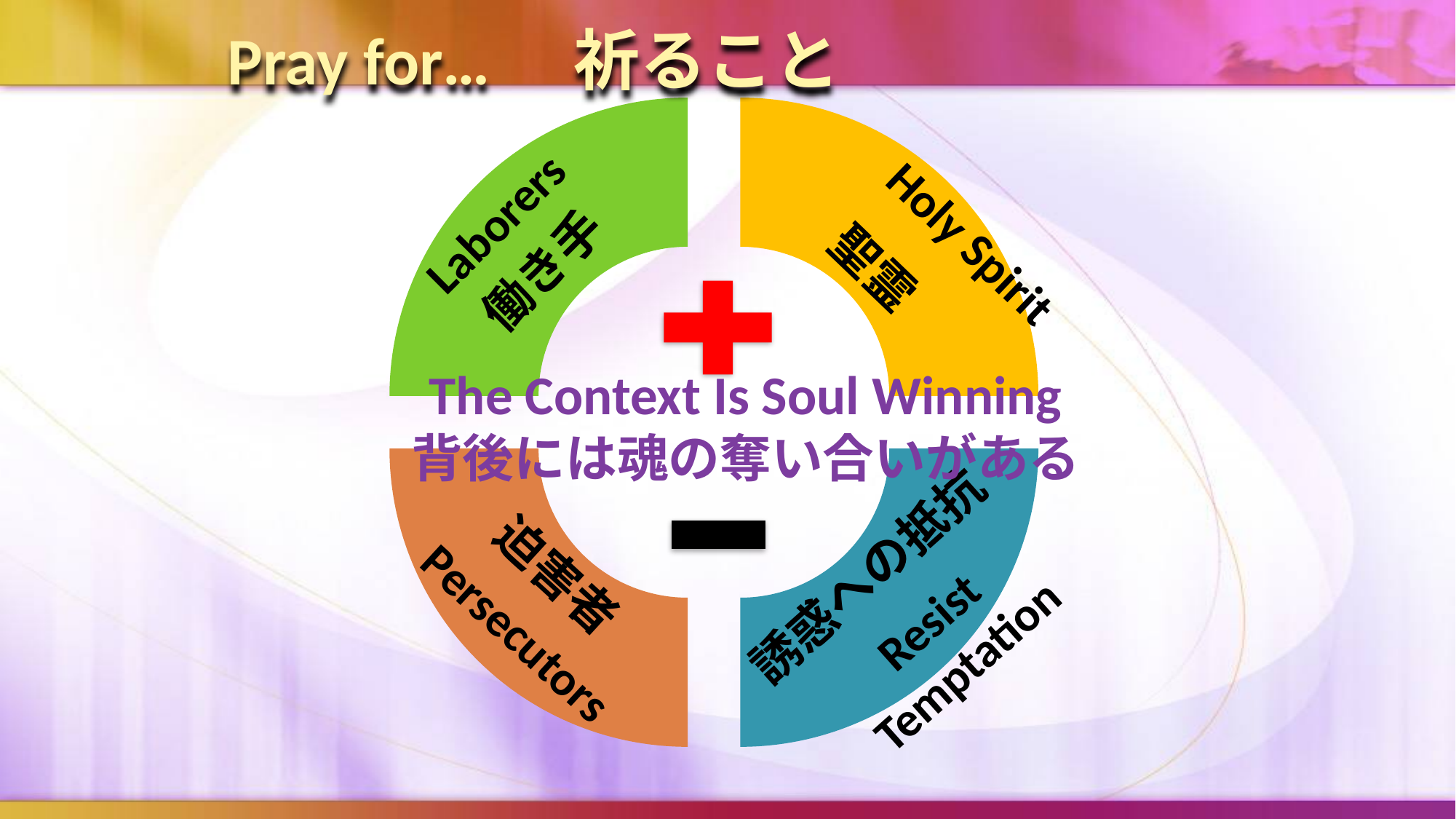
What is the label of the green segment of the doughnut chart? Laborers What is the English title at the top of the slide? Pray for... What colour is the segment labelled Holy Spirit? yellow Which segment of the doughnut chart is orange? Persecutors How many segments does the doughnut chart have? 4 What text is written in the centre of the doughnut chart in English? The Context Is Soul Winning Which segment is in the top-right position of the doughnut chart? Holy Spirit Which segment is in the bottom-left position of the doughnut chart? Persecutors Which segment of the doughnut chart is teal (blue-green)? Resist Temptation What kind of chart is shown on the slide? doughnut chart